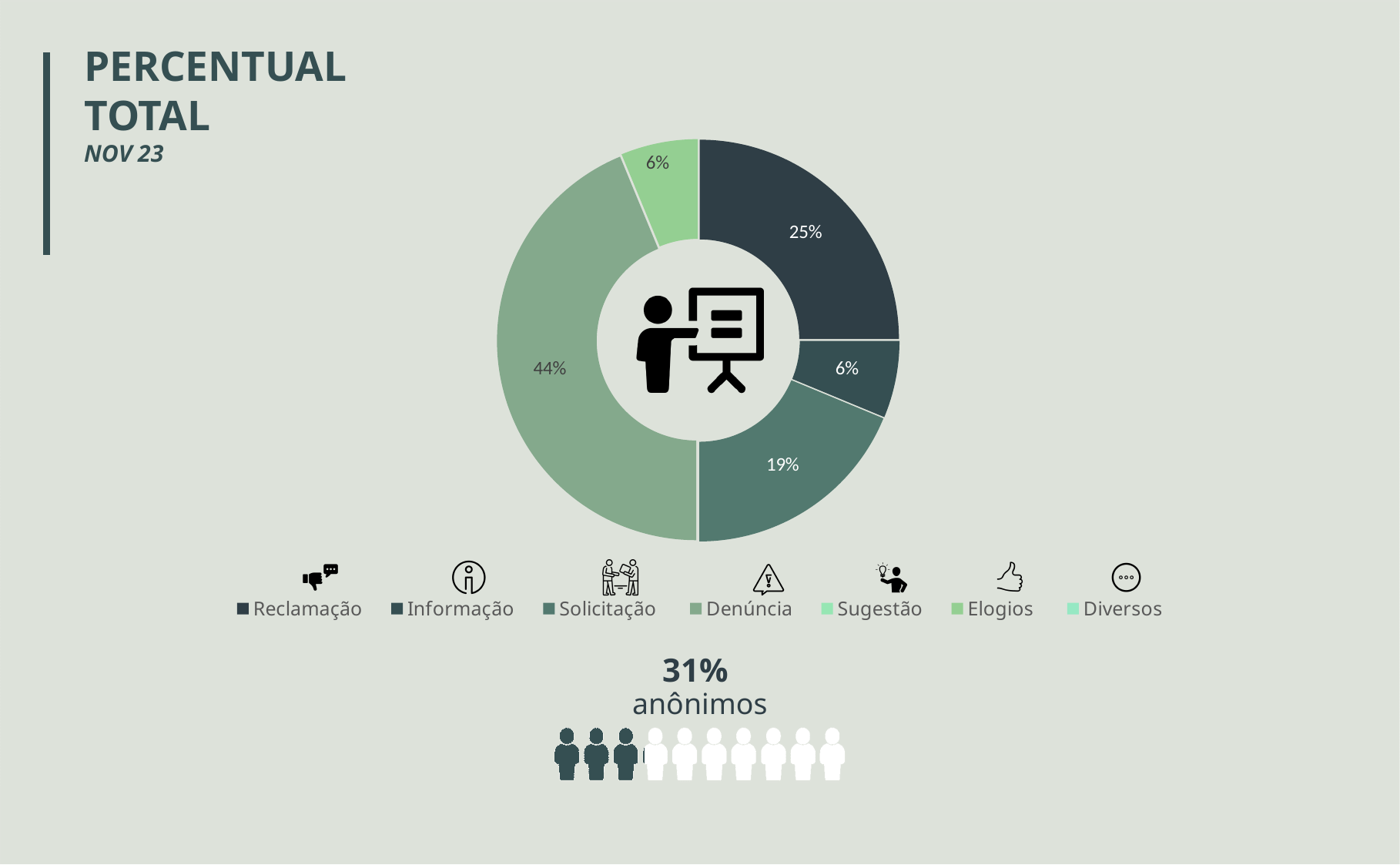
What is the title of the chart on the slide? PERCENTUAL TOTAL How many categories does the legend list? 7 What percentage does the Denúncia slice represent? 44% What percentage does the Solicitação slice represent? 19% How many slices with data labels are visible in the chart? 5 What percentage does the Informação slice represent? 6% Which category has the largest slice of the chart? Denúncia What kind of chart is shown on the slide? Pie (donut) chart Which slice is larger, Reclamação or Solicitação? Reclamação What is the difference in percentage points between the Denúncia and Reclamação slices? 19 What percentage does the Reclamação slice represent? 25%